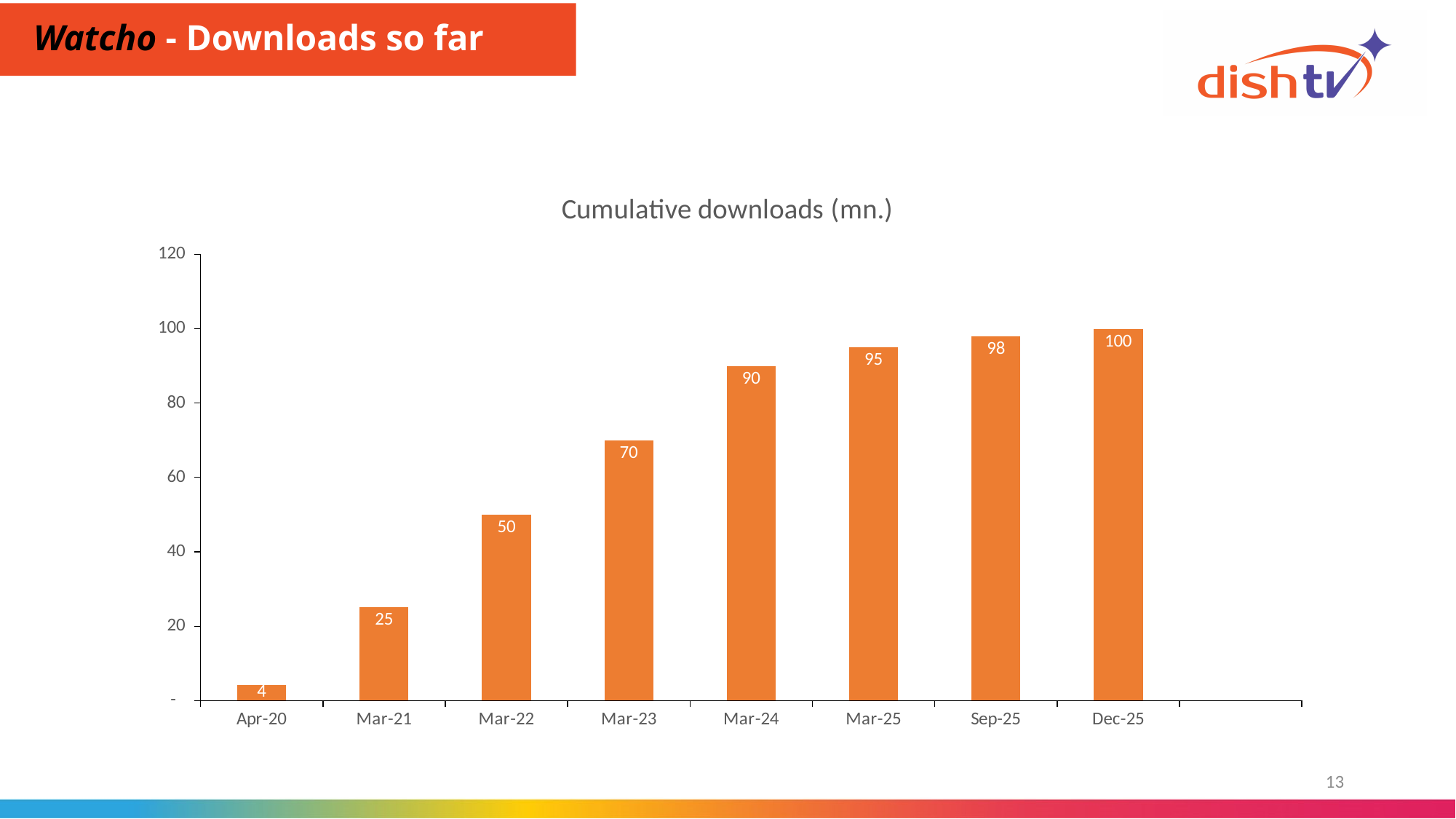
What is the value for Apr-20? 4 What is the value for Mar-22? 50 What is the title of the chart? Cumulative downloads (mn.) Is the value for Mar-23 greater or less than 60? greater What is the difference between the values for Mar-24 and Mar-23? 20 Which category has the lowest value? Apr-20 What kind of chart is shown on the slide? bar chart Do the values rise or fall from Apr-20 to Dec-25? rise How many categories are shown on the x axis? 8 What is the value for Dec-25? 100 Which category has the highest value? Dec-25 Which is larger, the value for Mar-21 or the value for Mar-22? Mar-22